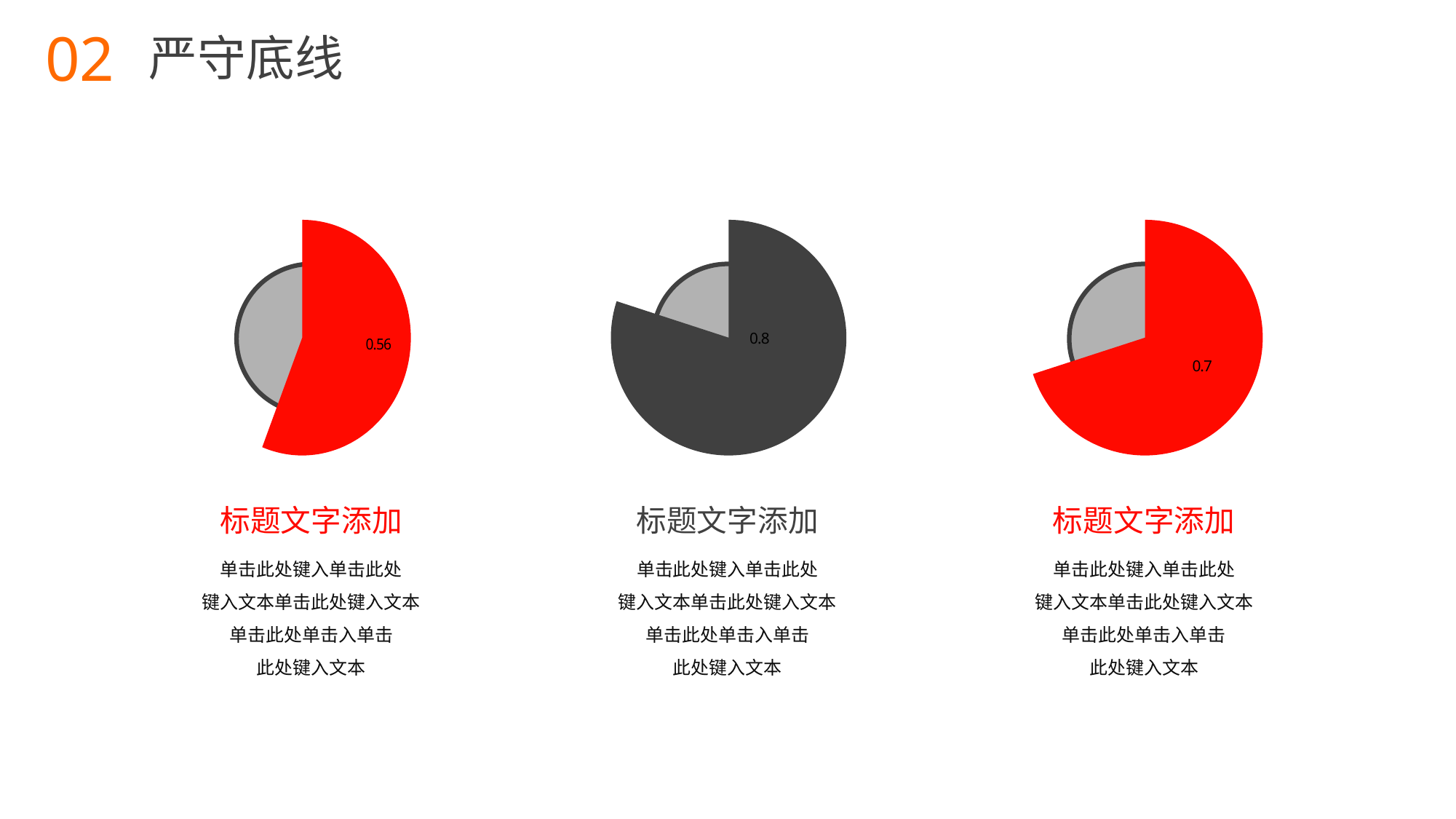
Which pie chart has the largest labelled slice value: the left, middle or right one? middle Is the labelled slice value in the right pie chart larger or smaller than the labelled slice value in the left pie chart? larger What kind of chart is shown on the left of the slide? pie chart In the right pie chart, what value is printed on the red slice? 0.7 What is the difference between the labelled slice values of the middle and left pie charts? 0.24 Which pie chart has the smallest labelled slice value: the left, middle or right one? left In the left pie chart, what value is printed on the red slice? 0.56 What colour is the labelled slice in the middle pie chart? dark grey How many pie charts are on the slide? 3 How many slices does each pie chart have? 2 Is the labelled slice value in the middle pie chart larger or smaller than the labelled slice value in the right pie chart? larger In the middle pie chart, what value is printed on the dark grey slice? 0.8